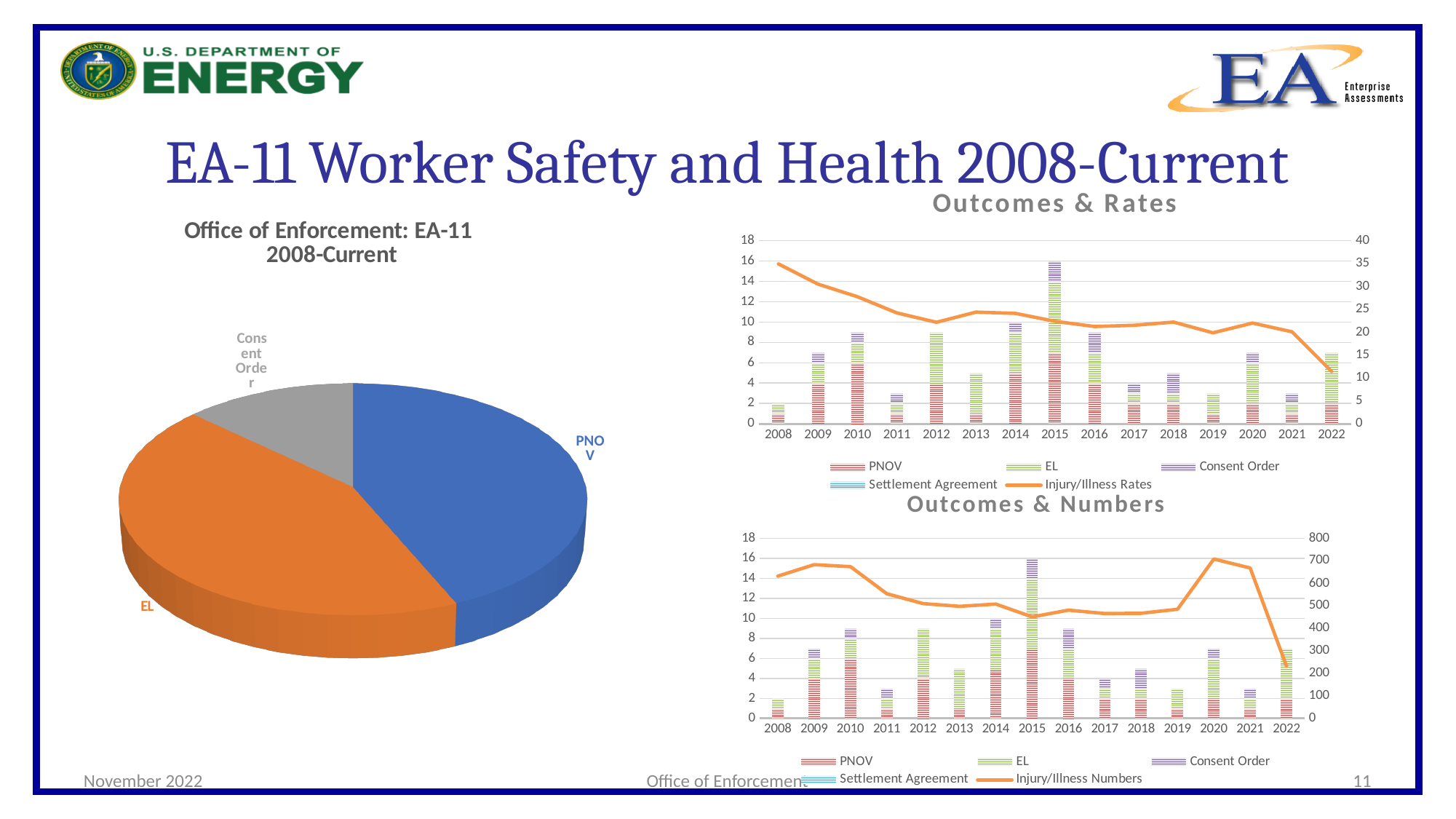
In the 'Outcomes & Rates' chart, does the Injury/Illness Rates line generally rise or fall from 2008 to 2022? fall What kind of chart is the 'Office of Enforcement: EA-11 2008-Current' chart on the left? pie chart In the 'Outcomes & Rates' chart, which year has the shortest stacked bar? 2008 In the 'Outcomes & Rates' chart, which year has the tallest stacked bar? 2015 In the 'Outcomes & Numbers' chart, how many years are shown on the x axis? 15 In the 'Office of Enforcement: EA-11 2008-Current' pie chart, which slice is larger, PNOV or Consent Order? PNOV In the 'Outcomes & Rates' chart, is the Injury/Illness Rates value for 2008 greater or less than 30 on the right axis? greater In the 'Outcomes & Rates' chart, how many series does the legend list? 5 In the 'Office of Enforcement: EA-11 2008-Current' pie chart, which category has the smallest slice? Consent Order How many slices does the 'Office of Enforcement: EA-11 2008-Current' pie chart have? 3 In the 'Outcomes & Numbers' chart, is the Injury/Illness Numbers value for 2020 greater or less than 600 on the right axis? greater